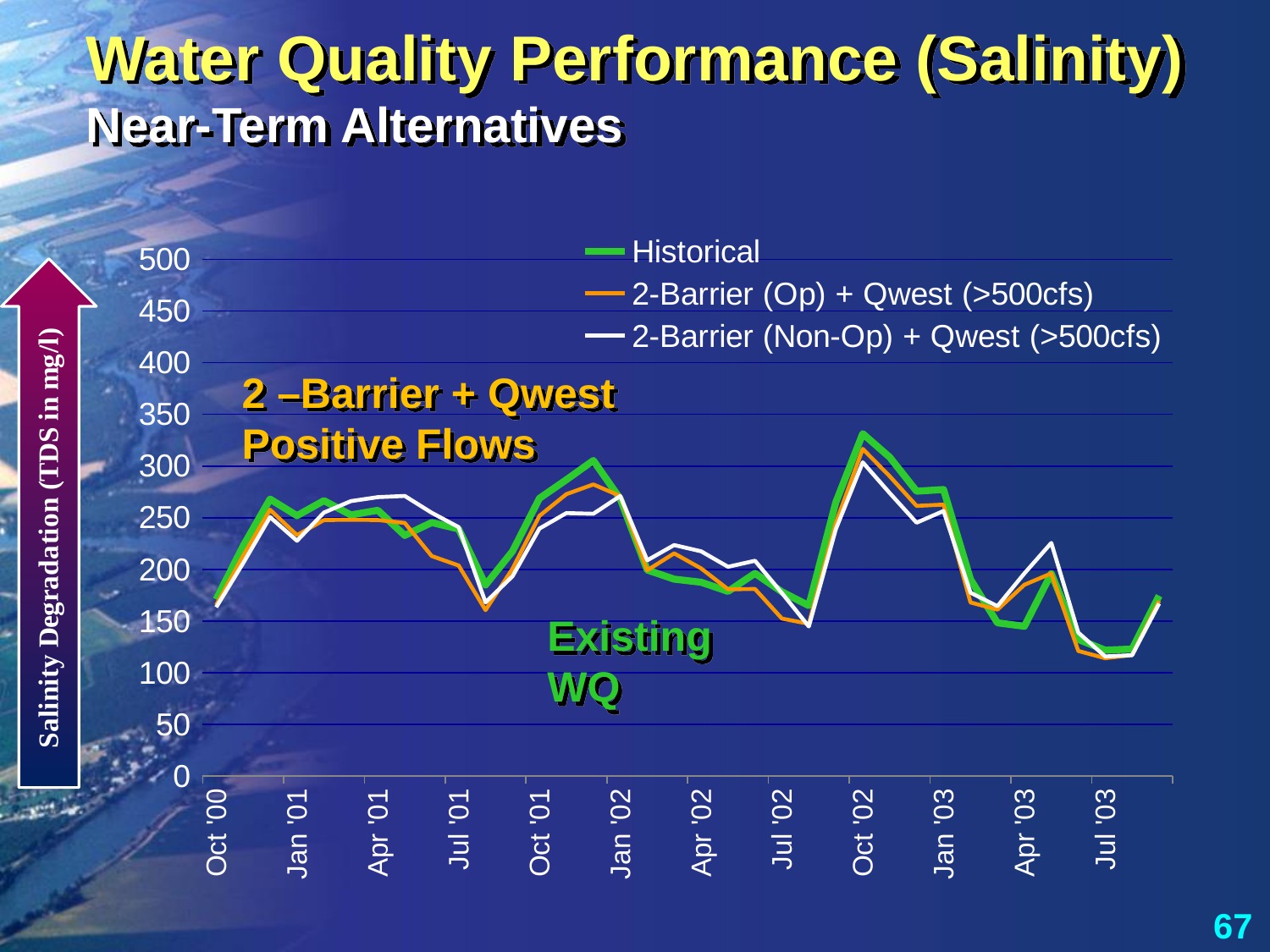
Is the Historical value at Jul '03 greater or less than 150? less At which x-axis date does the Historical series reach its highest value? Oct '02 Is the 2-Barrier (Op) + Qwest (>500cfs) value at Jul '02 greater or less than 200? less Is the Historical value at Oct '02 greater or less than 300? greater Between Oct '02 and Jul '03, does the Historical series generally rise or fall? fall How many date labels are shown along the x axis? 12 Which series in the legend is drawn in green? Historical How many series does the chart legend list? 3 What is the label on the vertical axis of the chart? Salinity Degradation (TDS in mg/l) What kind of chart is shown on the slide? line chart At which x-axis date does the Historical series reach its lowest value? Jul '03 Which is larger for the Historical series: the value at Oct '02 or the value at Jul '03? Oct '02